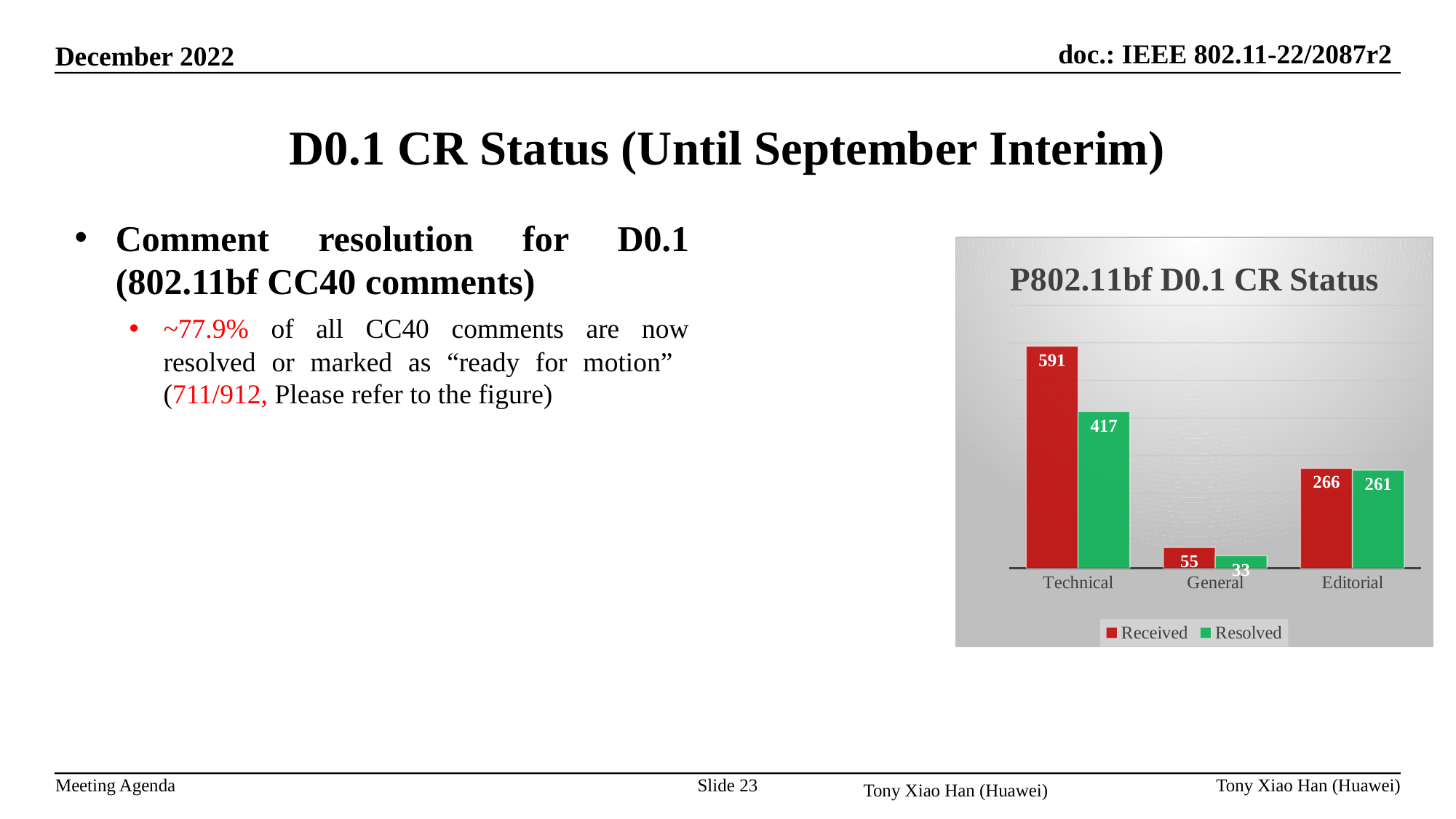
What is the difference between Received and Resolved for Technical? 174 What kind of chart is shown? Bar chart Which category has the highest Received value? Technical What is the Resolved value for General? 33 What is the Received value for Technical? 591 How many categories are shown on the x axis? 3 What is the difference between Received and Resolved for General? 22 Which is larger, the Received value for Editorial or the Resolved value for Technical? Resolved value for Technical How many series does the legend list? 2 Which category has the lowest Resolved value? General What is the title of the chart? P802.11bf D0.1 CR Status What is the Resolved value for Editorial? 261